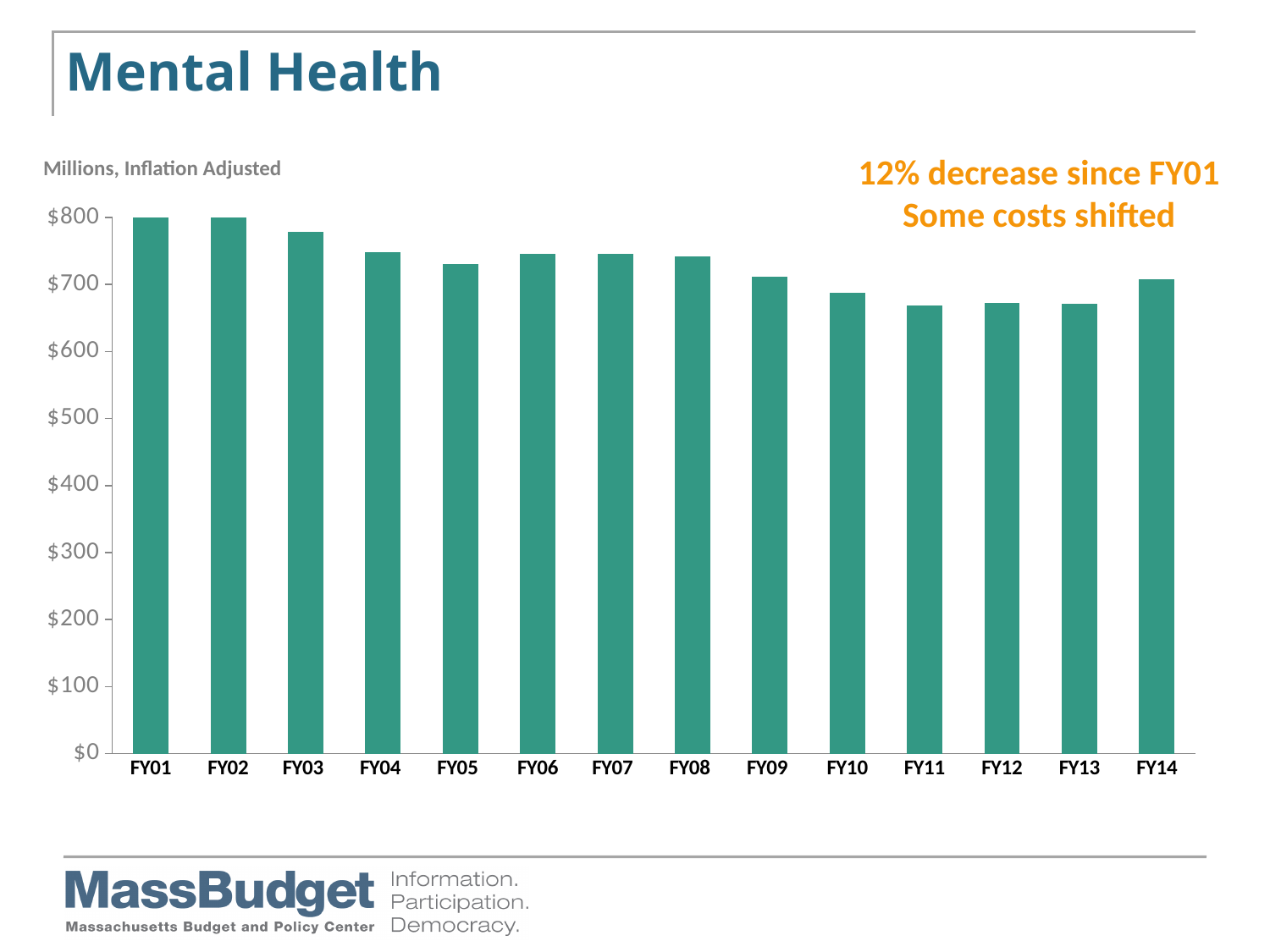
What kind of chart is shown on the slide? bar chart Which is larger, the value for FY01 or the value for FY14? FY01 How many fiscal years are plotted on the chart? 14 Is the value for FY03 greater or less than $800? less Which is larger, the value for FY05 or the value for FY03? FY03 Do the values generally rise or fall from FY01 to FY13? fall What unit label is shown above the chart's y axis? Millions, Inflation Adjusted What is the title of the slide containing the chart? Mental Health Is the value for FY11 greater or less than $700? less Is the value for FY01 greater or less than $700? greater